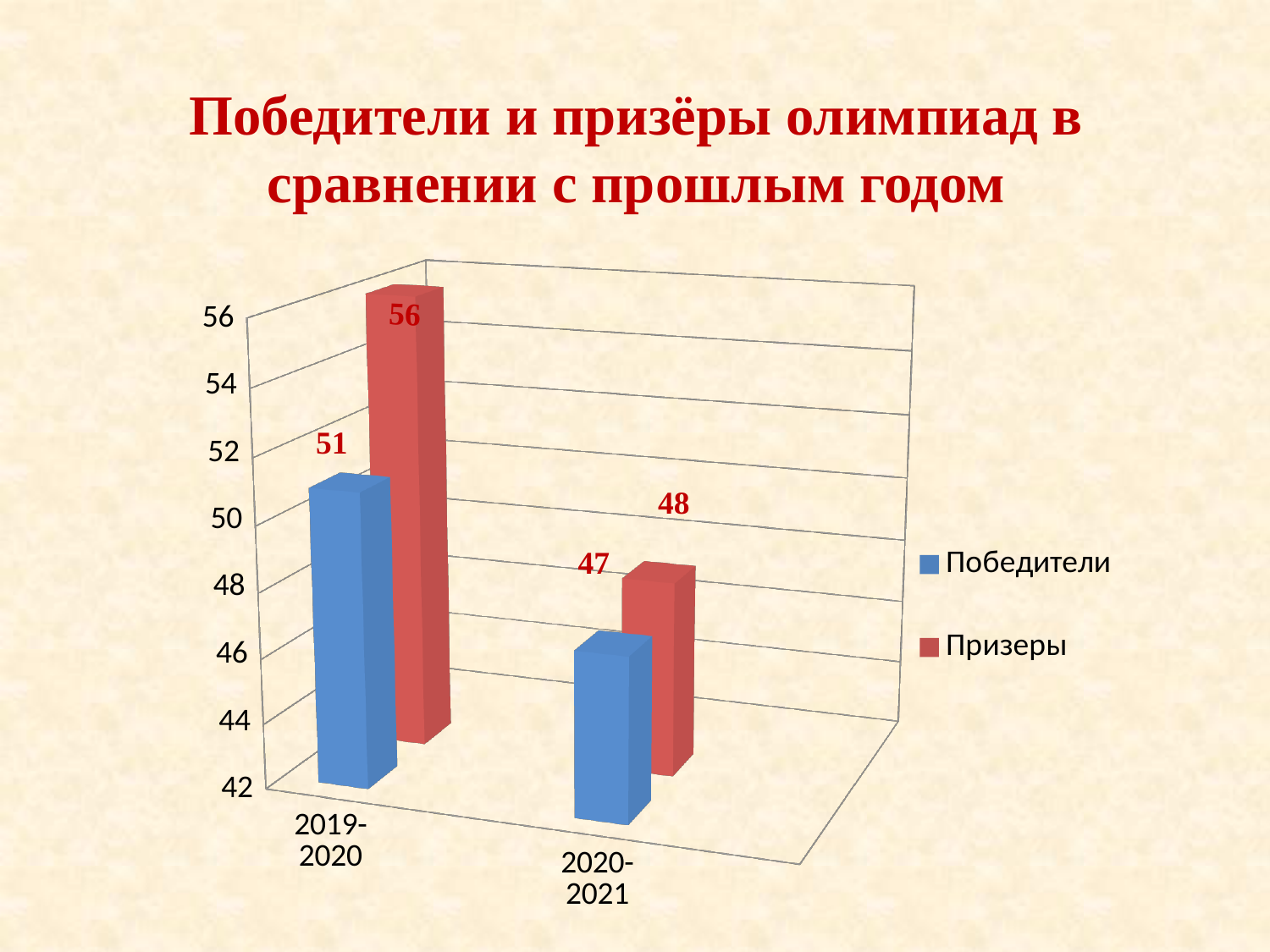
Which is larger: Победители in 2019-2020 or Победители in 2020-2021? Победители in 2019-2020 Which year has the lowest value for Победители? 2020-2021 Which year has the highest value for Призеры? 2019-2020 What is the value for Призеры in 2019-2020? 56 What is the value for Призеры in 2020-2021? 48 What is the difference between Победители and Призеры in 2019-2020? 5 What kind of chart is shown on the slide? Bar chart What is the value for Победители in 2020-2021? 47 What is the difference between Призеры in 2019-2020 and Призеры in 2020-2021? 8 Do the values for Призеры rise or fall from 2019-2020 to 2020-2021? Fall How many series does the legend list? 2 What is the value for Победители in 2019-2020? 51